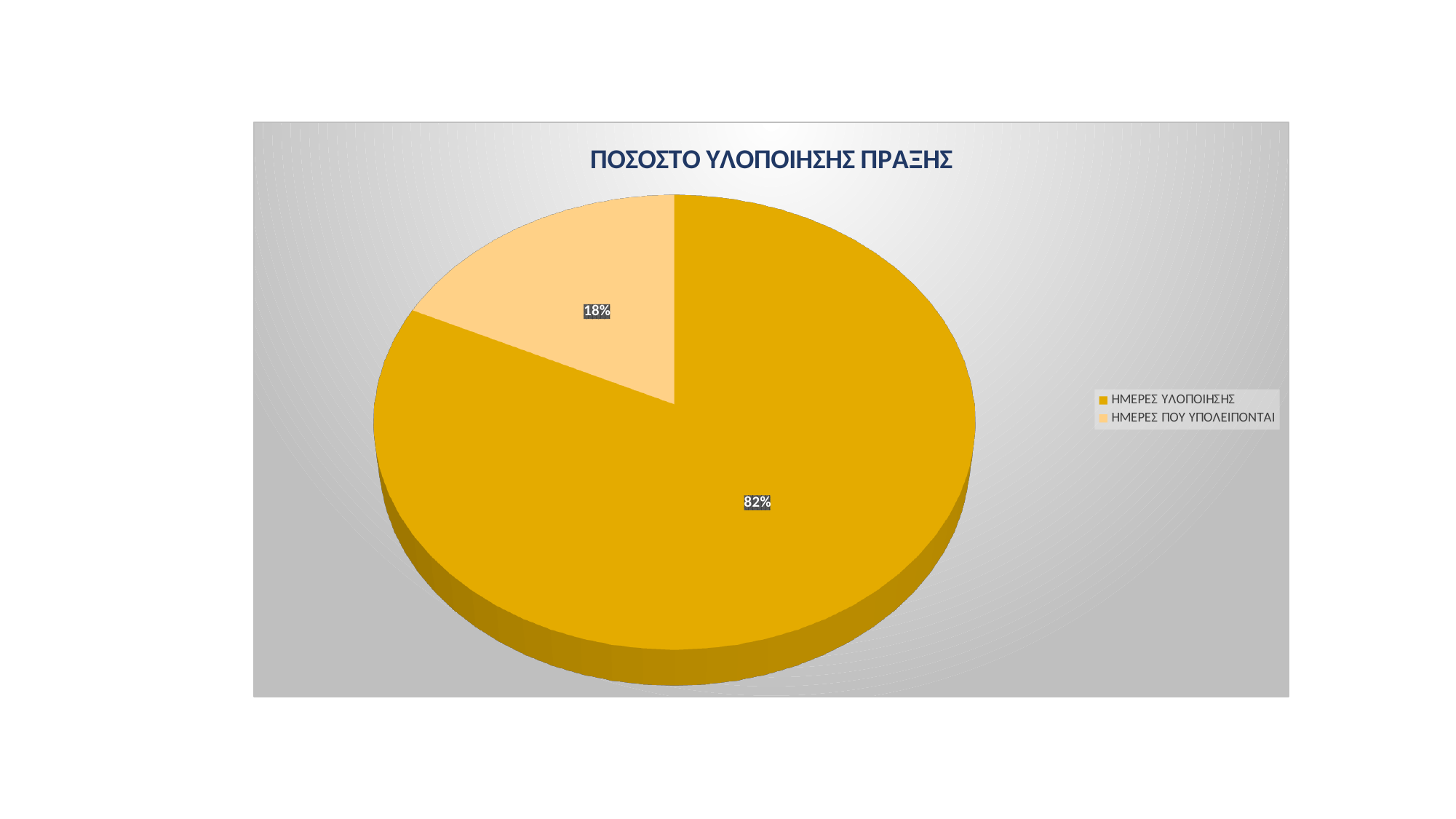
Which legend entry is shown in the lighter colour? ΗΜΕΡΕΣ ΠΟΥ ΥΠΟΛΕΙΠΟΝΤΑΙ What share of the pie does ΗΜΕΡΕΣ ΠΟΥ ΥΠΟΛΕΙΠΟΝΤΑΙ represent? 18% What type of chart is shown on the slide? pie chart Which slice is the smallest in the pie chart? ΗΜΕΡΕΣ ΠΟΥ ΥΠΟΛΕΙΠΟΝΤΑΙ What is the difference in percentage points between the ΗΜΕΡΕΣ ΥΛΟΠΟΙΗΣΗΣ slice and the ΗΜΕΡΕΣ ΠΟΥ ΥΠΟΛΕΙΠΟΝΤΑΙ slice? 64 percentage points Which slice is the largest in the pie chart? ΗΜΕΡΕΣ ΥΛΟΠΟΙΗΣΗΣ What is the title of the chart? ΠΟΣΟΣΤΟ ΥΛΟΠΟΙΗΣΗΣ ΠΡΑΞΗΣ How many entries does the legend list? 2 What share of the pie does ΗΜΕΡΕΣ ΥΛΟΠΟΙΗΣΗΣ represent? 82% How many slices does the pie chart have? 2 Which is larger, the ΗΜΕΡΕΣ ΥΛΟΠΟΙΗΣΗΣ slice or the ΗΜΕΡΕΣ ΠΟΥ ΥΠΟΛΕΙΠΟΝΤΑΙ slice? ΗΜΕΡΕΣ ΥΛΟΠΟΙΗΣΗΣ